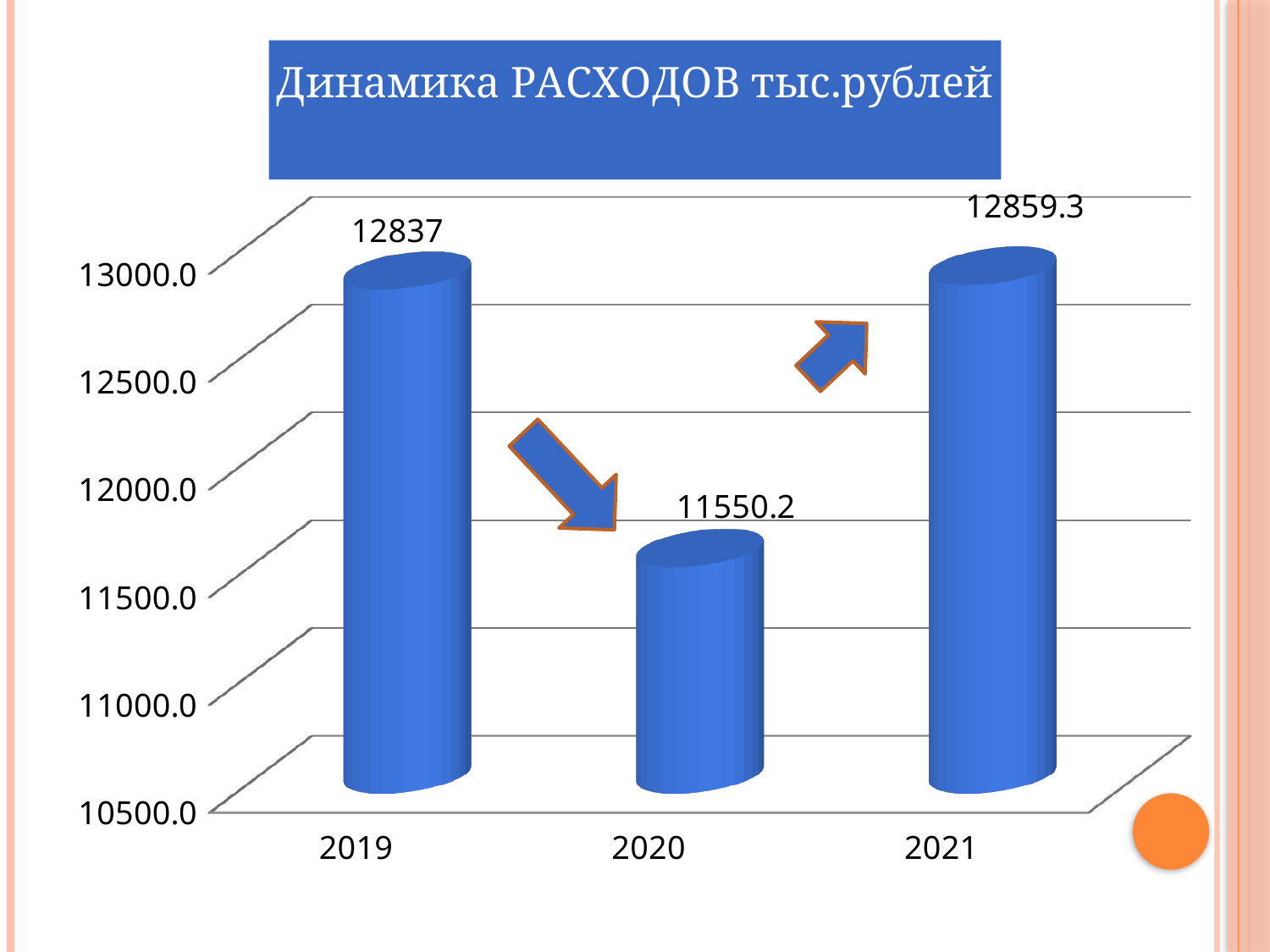
What is the difference between the values for 2021 and 2019? 22.3 What type of chart is shown on the slide? bar chart Which year has the lowest value? 2020 What is the value for 2020? 11550.2 What is the difference between the values for 2019 and 2020? 1286.8 Which year has the highest value? 2021 What is the title of the chart? Динамика РАСХОДОВ тыс.рублей What is the value for 2019? 12837 Is the value for 2020 greater or less than 12000? less Which is larger, the value for 2020 or the value for 2021? 2021 How many years are shown on the x axis? 3 What is the value for 2021? 12859.3